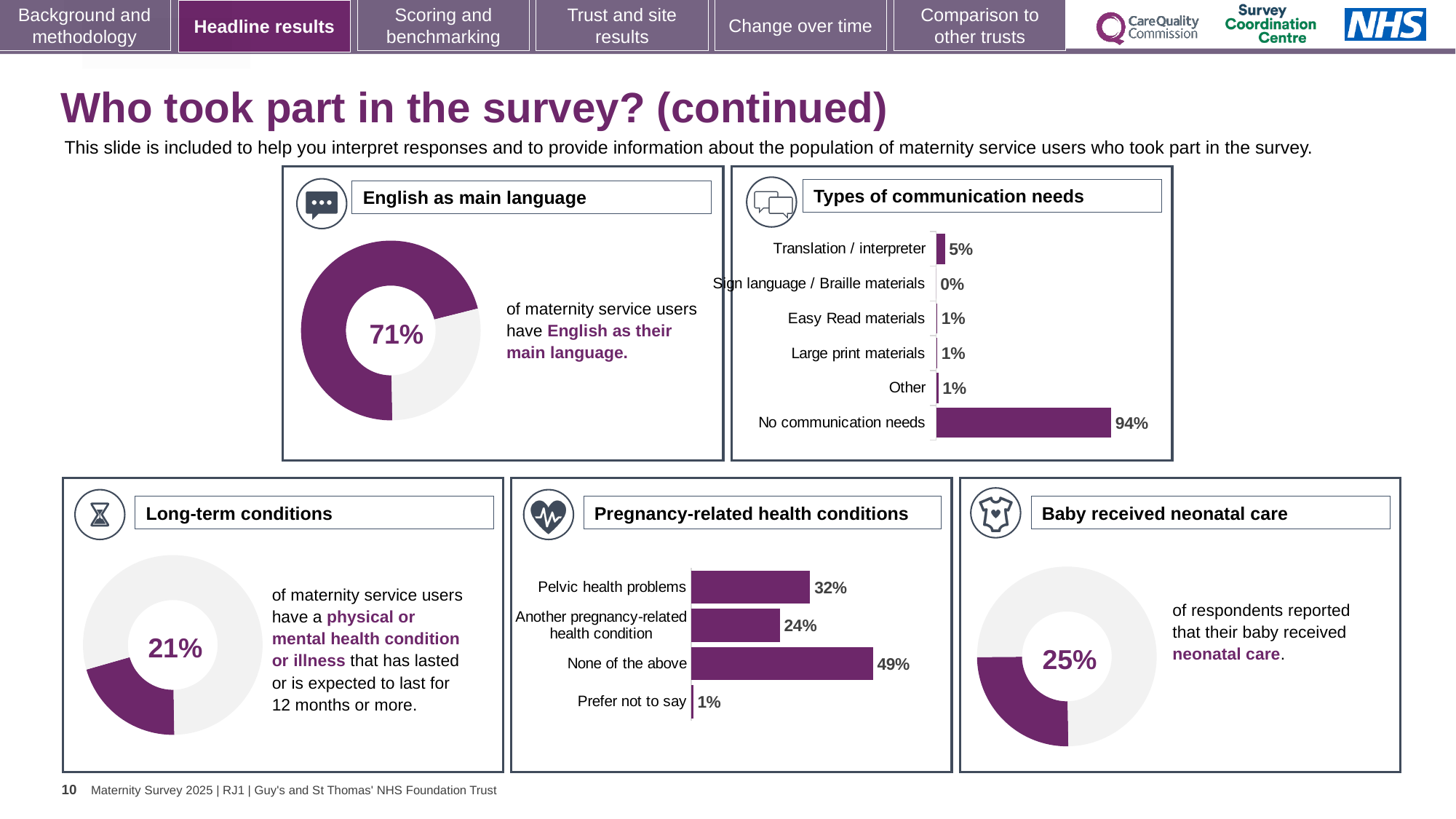
In the 'Pregnancy-related health conditions' chart, which is larger: Pelvic health problems or Another pregnancy-related health condition? Pelvic health problems In the 'Pregnancy-related health conditions' chart, what is the difference between None of the above and Another pregnancy-related health condition? 25% In the 'Types of communication needs' chart, which category has the highest value? No communication needs In the 'Pregnancy-related health conditions' chart, what is the value for Pelvic health problems? 32% In the 'Types of communication needs' chart, which category has the lowest value? Sign language / Braille materials In the 'Types of communication needs' chart, how many categories are shown? 6 In the 'Types of communication needs' chart, what is the value for Translation / interpreter? 5% What kind of chart is used for 'Baby received neonatal care'? Donut chart In the 'Long-term conditions' chart, what percentage of maternity service users have a physical or mental health condition or illness? 21% In the 'Types of communication needs' chart, what is the difference between No communication needs and Translation / interpreter? 89% In the 'English as main language' chart, what percentage of maternity service users have English as their main language? 71% In the 'Pregnancy-related health conditions' chart, which category has the highest value? None of the above